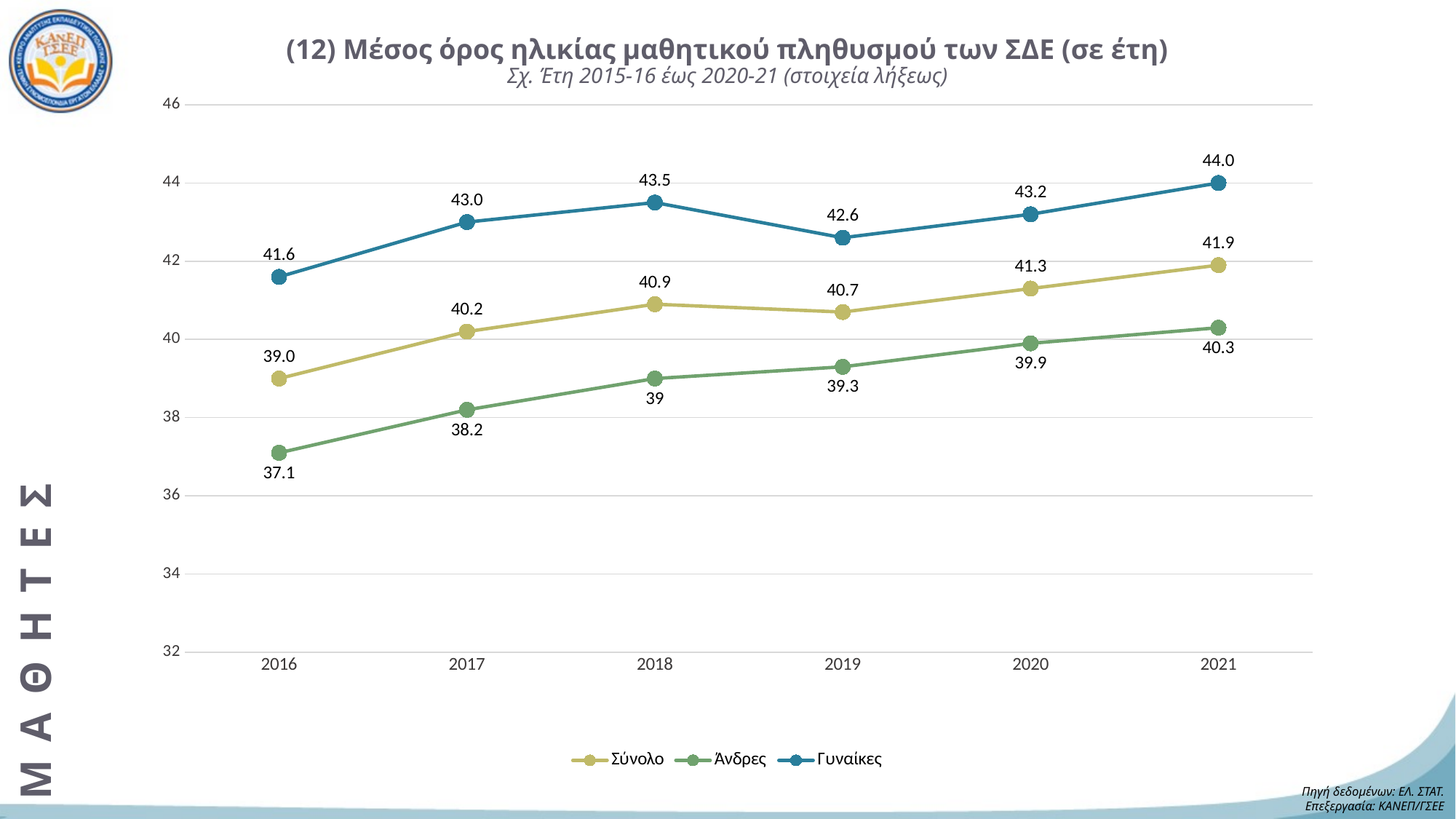
Does the Άνδρες series rise or fall from 2016 to 2021? rise Which series is drawn in blue? Γυναίκες How many years are shown on the x axis? 6 How many series does the legend list? 3 What is the difference between the Γυναίκες and Άνδρες values in 2021? 3.7 What is the value for Γυναίκες in 2021? 44.0 In which year is the value for Γυναίκες lowest? 2016 In which year is the value for Σύνολο highest? 2021 What is the value for Άνδρες in 2016? 37.1 What is the value for Σύνολο in 2019? 40.7 What kind of chart is this? line chart Which is larger, the Γυναίκες value in 2018 or the Γυναίκες value in 2019? 2018